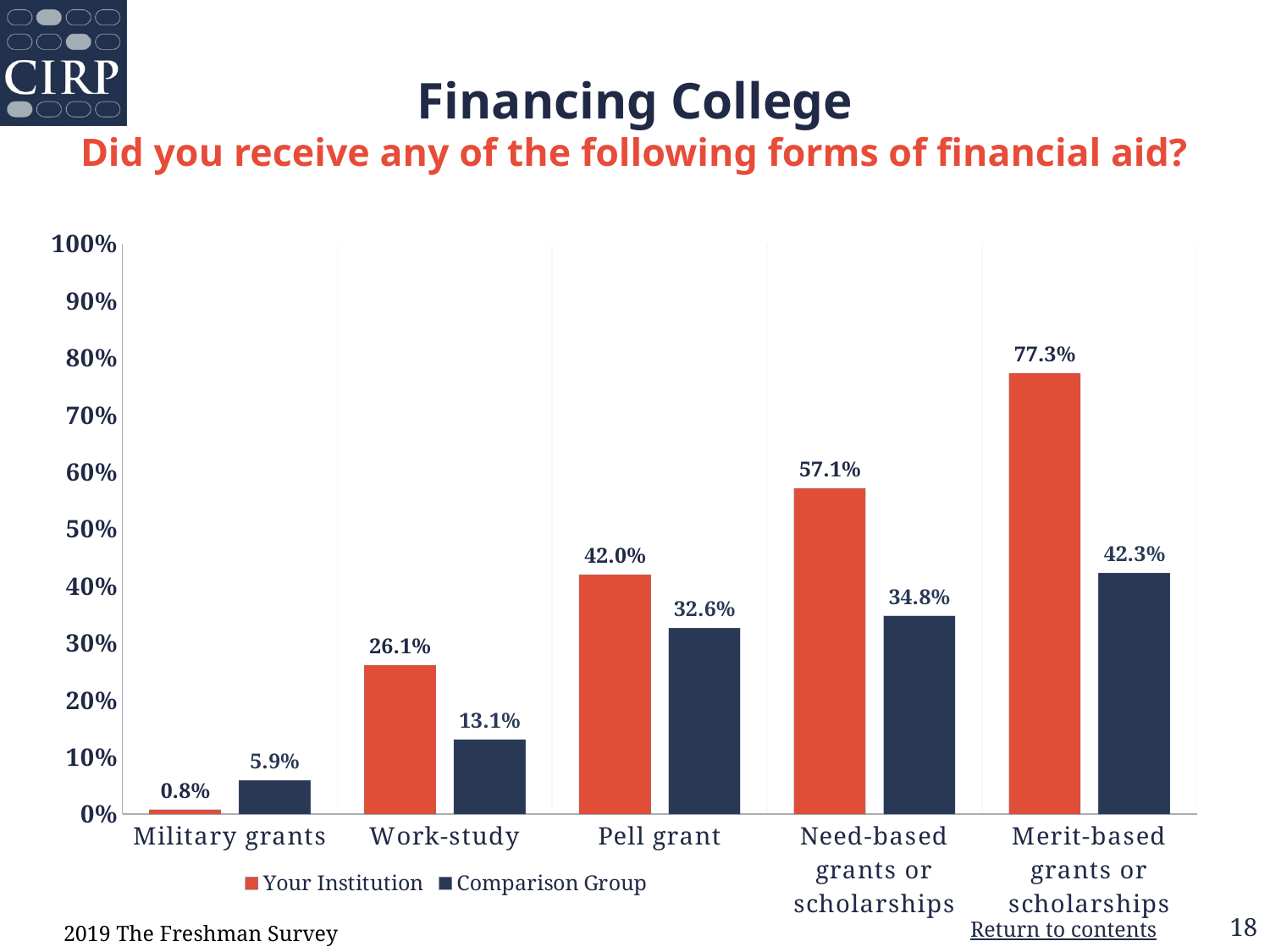
What is the difference between Your Institution and the Comparison Group for Merit-based grants or scholarships? 35.0% What is the Comparison Group value for Work-study? 13.1% Which form of financial aid has the lowest value for the Comparison Group? Military grants Which colour represents the Comparison Group in the chart? Dark navy blue For Need-based grants or scholarships, which is larger: Your Institution or the Comparison Group? Your Institution What kind of chart is shown on the slide? Bar chart How many series does the legend list? 2 What percentage of Your Institution students received a Pell grant? 42.0% Which form of financial aid has the highest value for Your Institution? Merit-based grants or scholarships Is the Comparison Group value for Pell grant greater or less than 30%? greater How many forms of financial aid are shown on the x axis? 5 What is the Your Institution value for Military grants? 0.8%